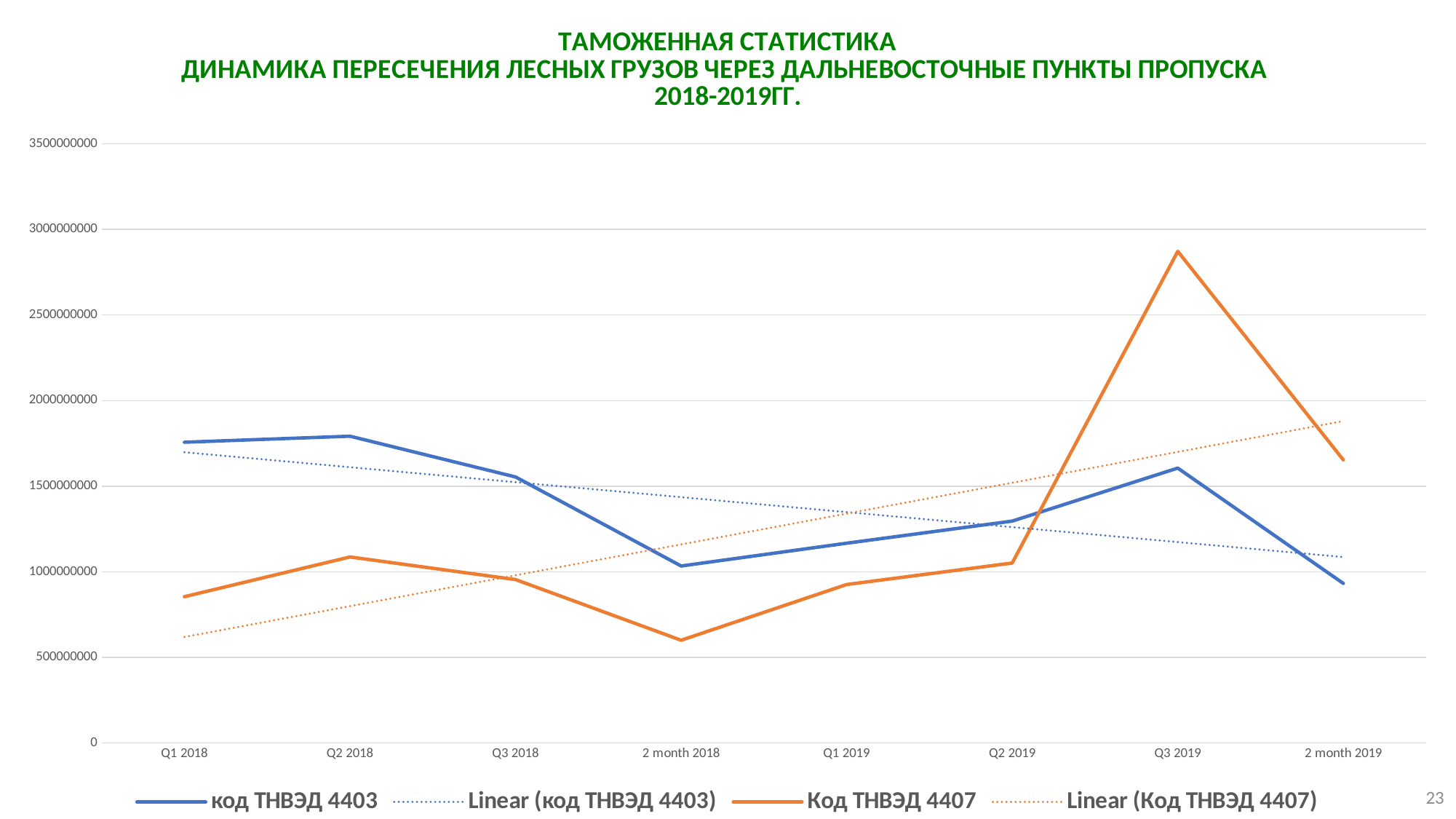
How many time periods are shown on the x axis of the chart? 8 What kind of chart is shown on the slide? line chart Is the value for Код ТНВЭД 4407 in Q3 2019 greater or less than 2500000000? greater In which period does the series Код ТНВЭД 4407 reach its lowest value? 2 month 2018 In which period does the series код ТНВЭД 4403 reach its lowest value? 2 month 2019 Does the dotted trendline Linear (код ТНВЭД 4403) rise or fall from left to right? fall Which colour is used for the series Код ТНВЭД 4407? orange Is the value for код ТНВЭД 4403 in Q1 2018 greater or less than 1500000000? greater Which series has the larger value in Q2 2018, код ТНВЭД 4403 or Код ТНВЭД 4407? код ТНВЭД 4403 Is the value for Код ТНВЭД 4407 in 2 month 2018 greater or less than 1000000000? less In which period does the series Код ТНВЭД 4407 reach its highest value? Q3 2019 How many entries does the chart legend list? 4